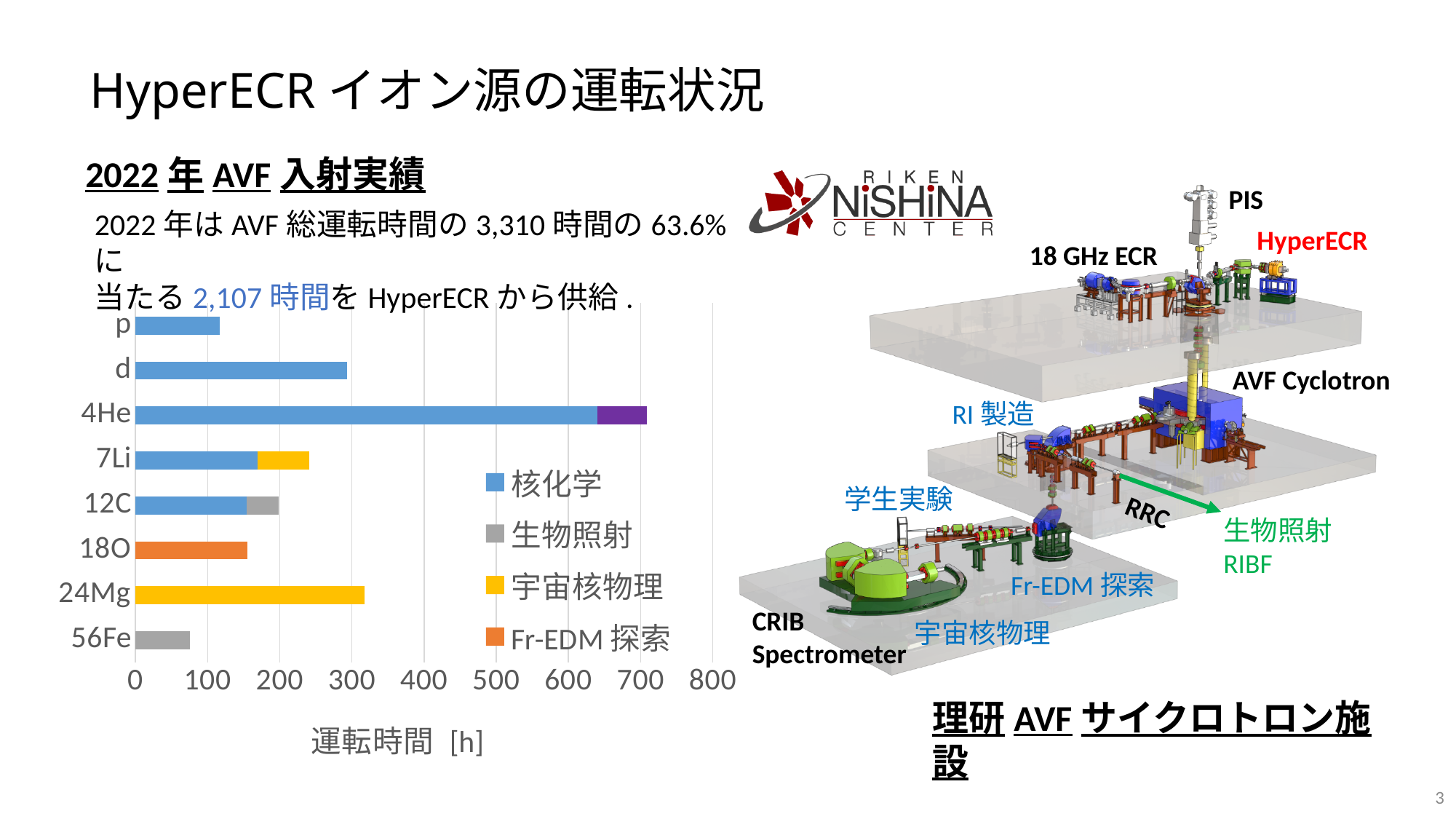
Is the value for 24Mg greater or less than 200? greater Is the total value for 4He greater or less than 600? greater What is the title of the x axis of the bar chart? 運転時間 [h] How many series does the legend of the bar chart list? 4 Is the value for p greater or less than 200? less Which has the longer bar, d or p? d Which ion species has the longest bar in the chart? 4He Which has the longer bar, 24Mg or 18O? 24Mg How many categories (ion species) are shown on the y axis of the bar chart? 8 Which ion species has the shortest bar in the chart? 56Fe What kind of chart is shown on the slide? bar chart